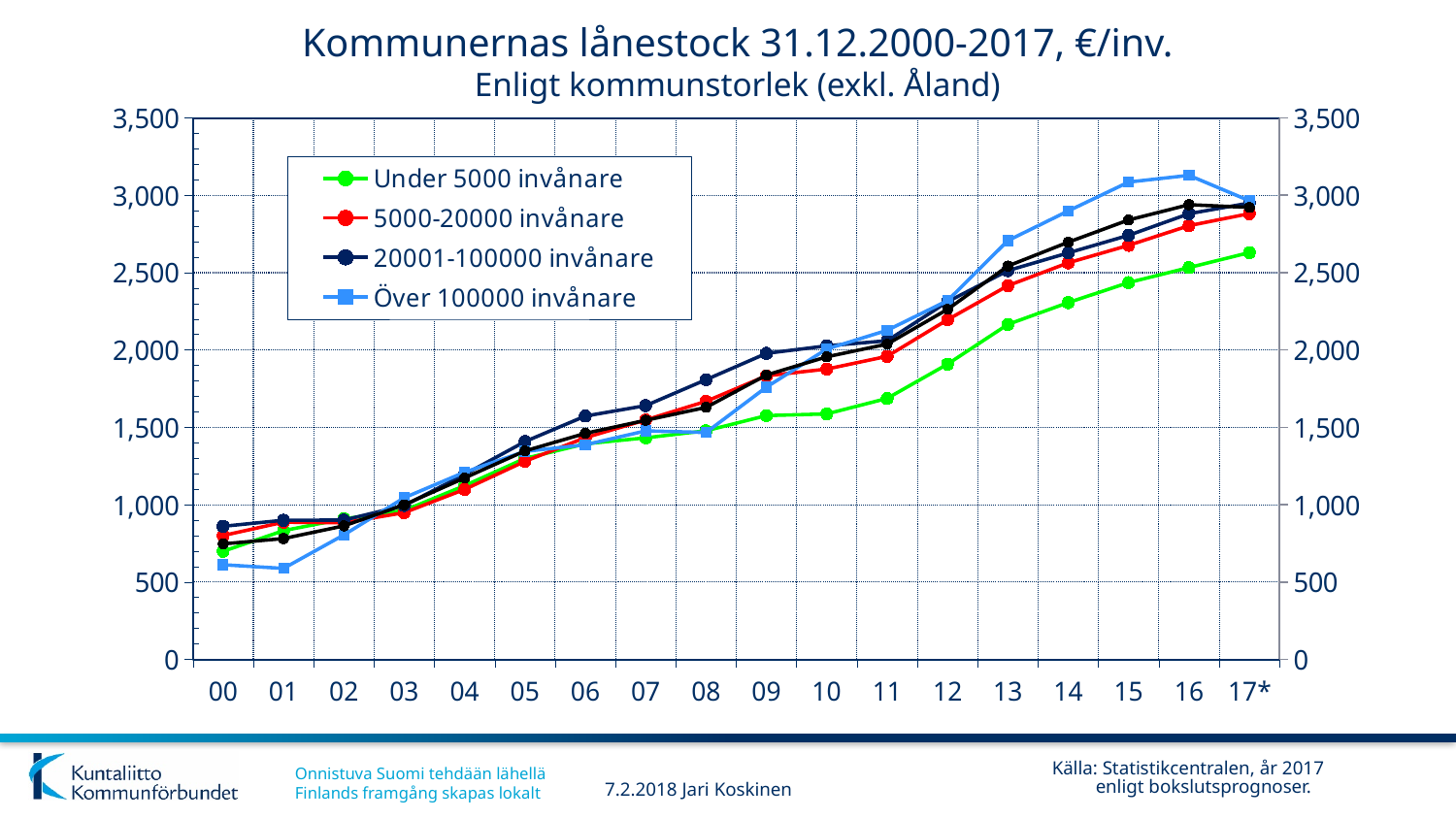
Do the values for the series generally rise or fall from 00 to 17*? Rise Is the value for Under 5000 invånare in 17* greater or less than 3,000? less Is the value for Över 100000 invånare in 16 greater or less than 3,000? greater Which legend entry is drawn with square markers? Över 100000 invånare What kind of chart is shown on the slide? Line chart How many series does the legend list? 4 How many years are shown along the x axis? 18 Which series has the lowest value in 17*? Under 5000 invånare In 13, which is larger: the value for Under 5000 invånare or the value for Över 100000 invånare? Över 100000 invånare Is the value for Under 5000 invånare in 00 greater or less than 1,000? less Which series has the highest value in 16? Över 100000 invånare